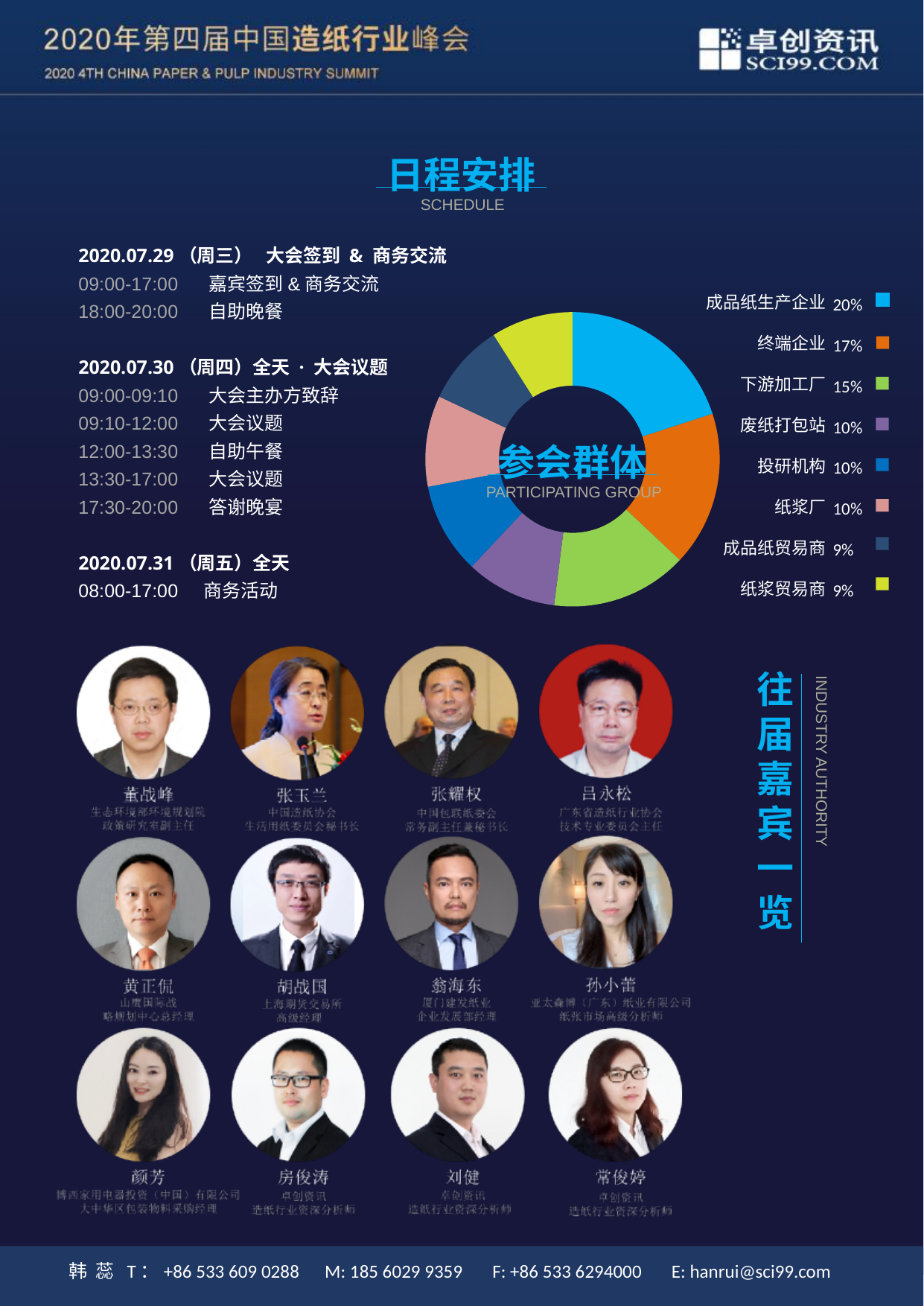
What share of the participating group does 成品纸生产企业 represent in the 参会群体 chart? 20% What kind of chart is the 参会群体 chart? Pie chart (donut) Which category has the largest share in the 参会群体 chart? 成品纸生产企业 What is the English subtitle shown under the 参会群体 chart title? PARTICIPATING GROUP What percentage is shown for 纸浆厂 in the 参会群体 chart? 10% How many categories in the 参会群体 chart have a share of exactly 10%? 3 Which has a larger share in the 参会群体 chart, 终端企业 or 下游加工厂? 终端企业 How many categories are shown in the 参会群体 chart? 8 What percentage is shown for 终端企业 in the 参会群体 chart? 17% What percentage is shown for 下游加工厂 in the 参会群体 chart? 15% What percentage is shown for 成品纸贸易商 in the 参会群体 chart? 9% What is the difference in percentage points between 成品纸生产企业 and 终端企业 in the 参会群体 chart? 3%